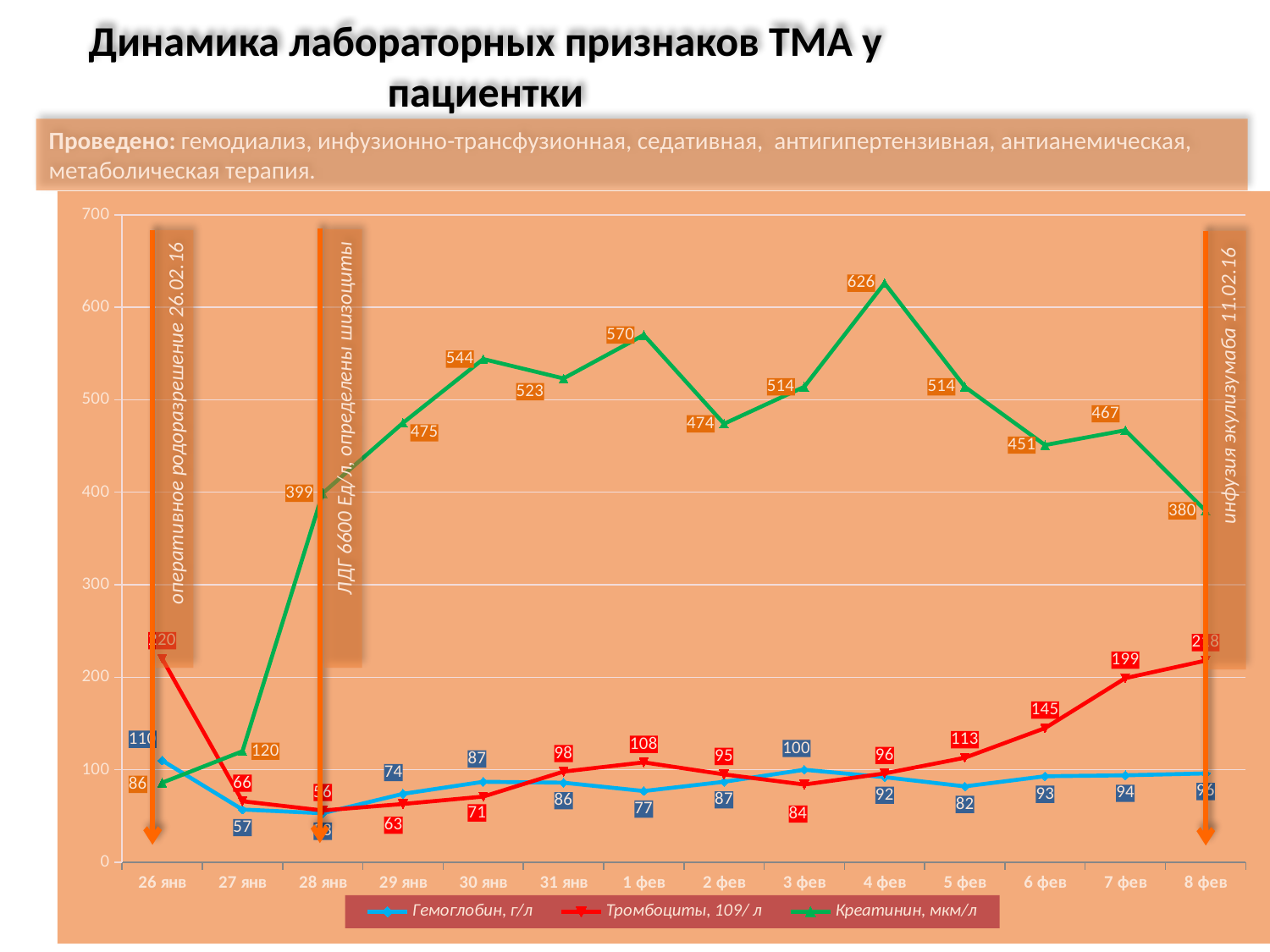
Is the value for Тромбоциты, 109/ л on 8 фев greater or less than 200? greater What kind of chart is shown on the slide? line chart On which date is Креатинин, мкм/л lowest? 26 янв Do the Тромбоциты, 109/ л values rise or fall from 3 фев to 8 фев? rise Which is larger: Креатинин, мкм/л on 30 янв or on 31 янв? 30 янв What is the difference between the Креатинин, мкм/л values on 4 фев and 8 фев? 246 How many series does the legend list? 3 What is the value of Гемоглобин, г/л on 3 фев? 100 How many dates are shown on the x axis? 14 What is the value of Креатинин, мкм/л on 4 фев? 626 On which date is Креатинин, мкм/л highest? 4 фев What is the value of Тромбоциты, 109/ л on 7 фев? 199